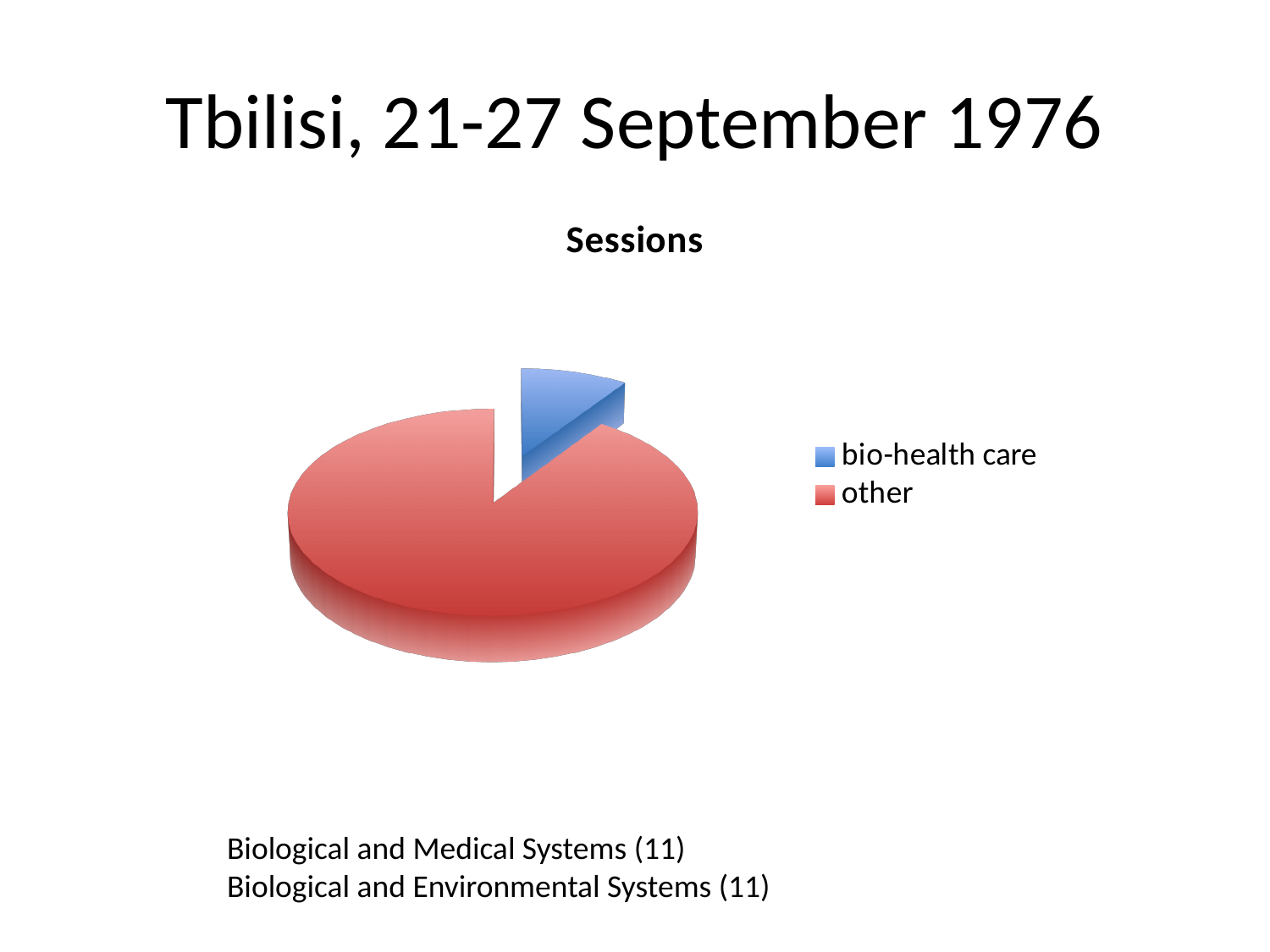
How many slices does the pie chart have? 2 What kind of chart is shown on the slide? pie chart Which category has the smallest slice of the pie? bio-health care What is the title of the chart? Sessions How many entries does the chart legend list? 2 Which category has the largest slice of the pie? other Is the bio-health care slice more or less than half of the pie? less What colour is the bio-health care slice? blue Which slice is larger, bio-health care or other? other